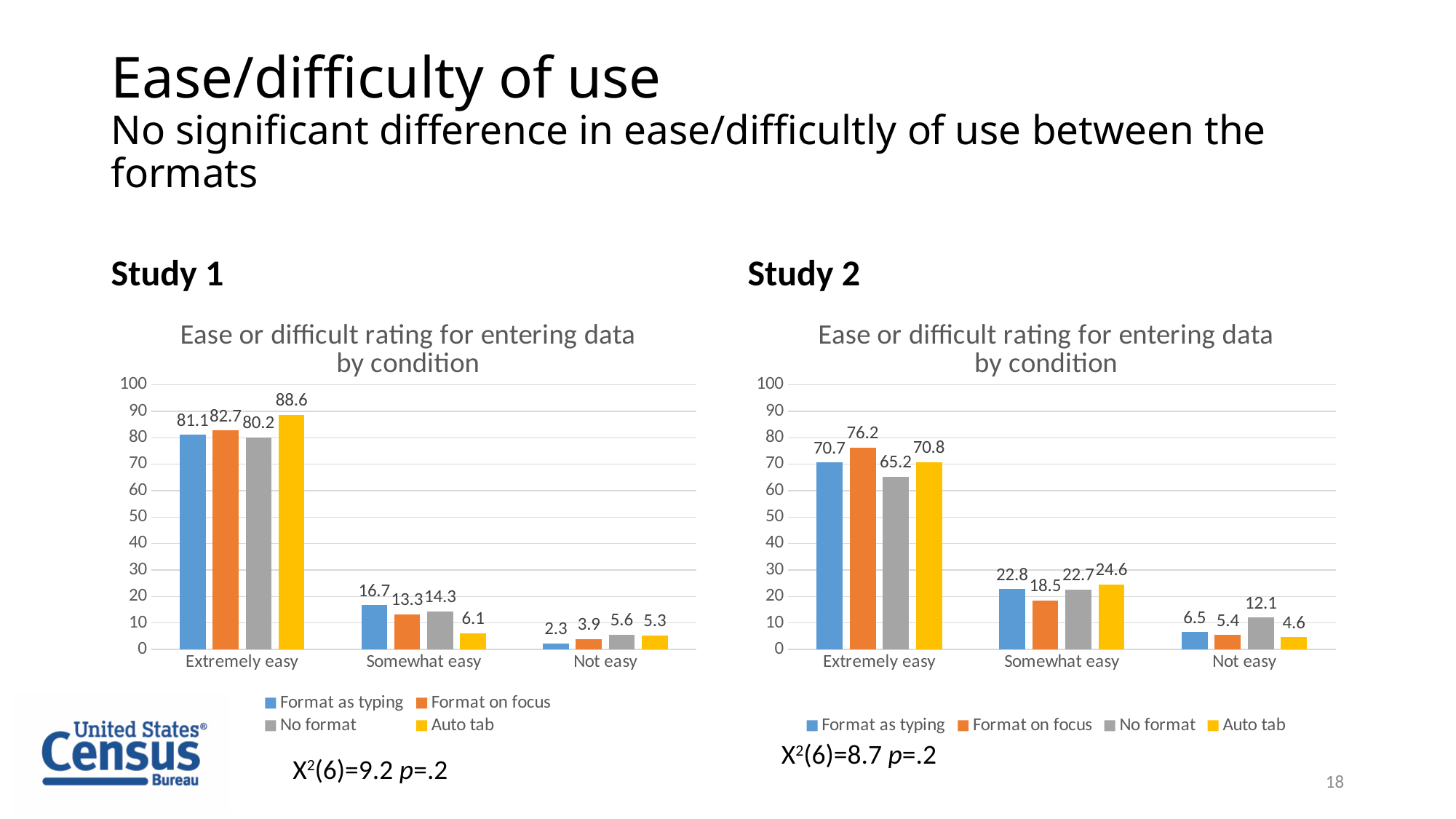
In the Study 1 chart, what is the value for Format as typing in the Somewhat easy category? 16.7 How many series does the legend of the Study 2 chart list? 4 In the Study 2 chart, which colour represents the Auto tab series? Yellow In the Study 2 chart, what is the difference between the Format as typing and Format on focus values in the Somewhat easy category? 4.3 In the Study 1 chart, what is the value for Auto tab in the Extremely easy category? 88.6 In the Study 1 chart, what is the difference between the Auto tab and No format values in the Extremely easy category? 8.4 In the Study 2 chart, which is larger in the Not easy category: Format as typing or Auto tab? Format as typing What kind of chart is the Study 1 chart? Bar chart How many categories are shown on the x axis of the Study 1 chart? 3 In the Study 1 chart, which series has the lowest value in the Not easy category? Format as typing In the Study 2 chart, which series has the highest value in the Extremely easy category? Format on focus In the Study 2 chart, what is the value for No format in the Not easy category? 12.1